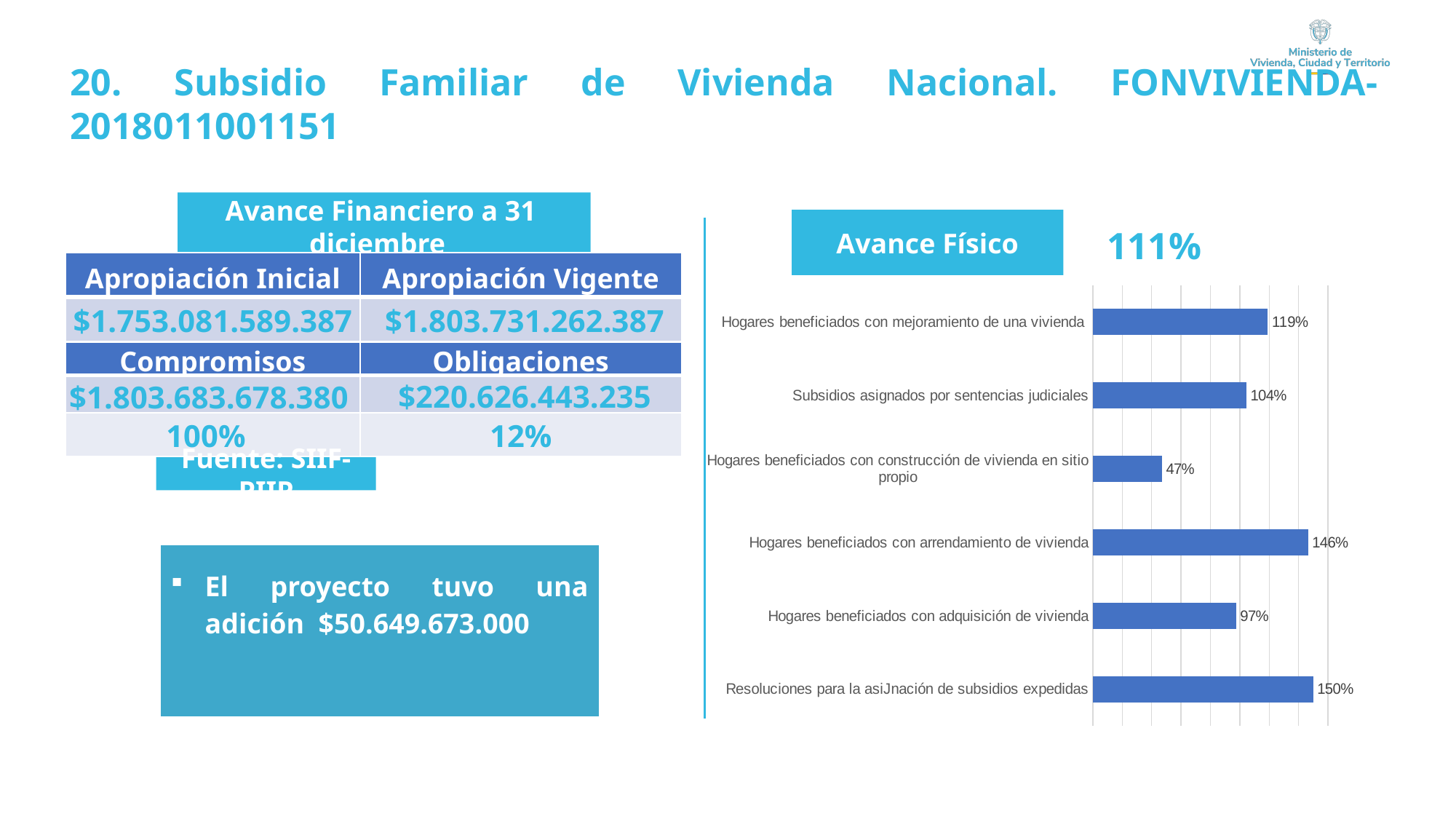
Which category has the highest value in the Avance Físico chart? Resoluciones para la asiJnación de subsidios expedidas What is the value for 'Hogares beneficiados con construcción de vivienda en sitio propio'? 47% Which is larger: the value for 'Hogares beneficiados con arrendamiento de vivienda' or for 'Hogares beneficiados con adquisición de vivienda'? Hogares beneficiados con arrendamiento de vivienda What is the difference in percentage points between 'Hogares beneficiados con mejoramiento de una vivienda' and 'Subsidios asignados por sentencias judiciales'? 15 percentage points What is the difference in percentage points between 'Resoluciones para la asiJnación de subsidios expedidas' and 'Hogares beneficiados con arrendamiento de vivienda'? 4 percentage points What is the value for 'Hogares beneficiados con adquisición de vivienda'? 97% What colour are the bars in the Avance Físico chart? Blue What is the value for 'Hogares beneficiados con mejoramiento de una vivienda' in the Avance Físico chart? 119% What kind of chart is used to show the Avance Físico data? Bar chart What is the value for 'Subsidios asignados por sentencias judiciales' in the Avance Físico chart? 104% Which category has the lowest value in the Avance Físico chart? Hogares beneficiados con construcción de vivienda en sitio propio How many categories are shown in the Avance Físico chart? 6